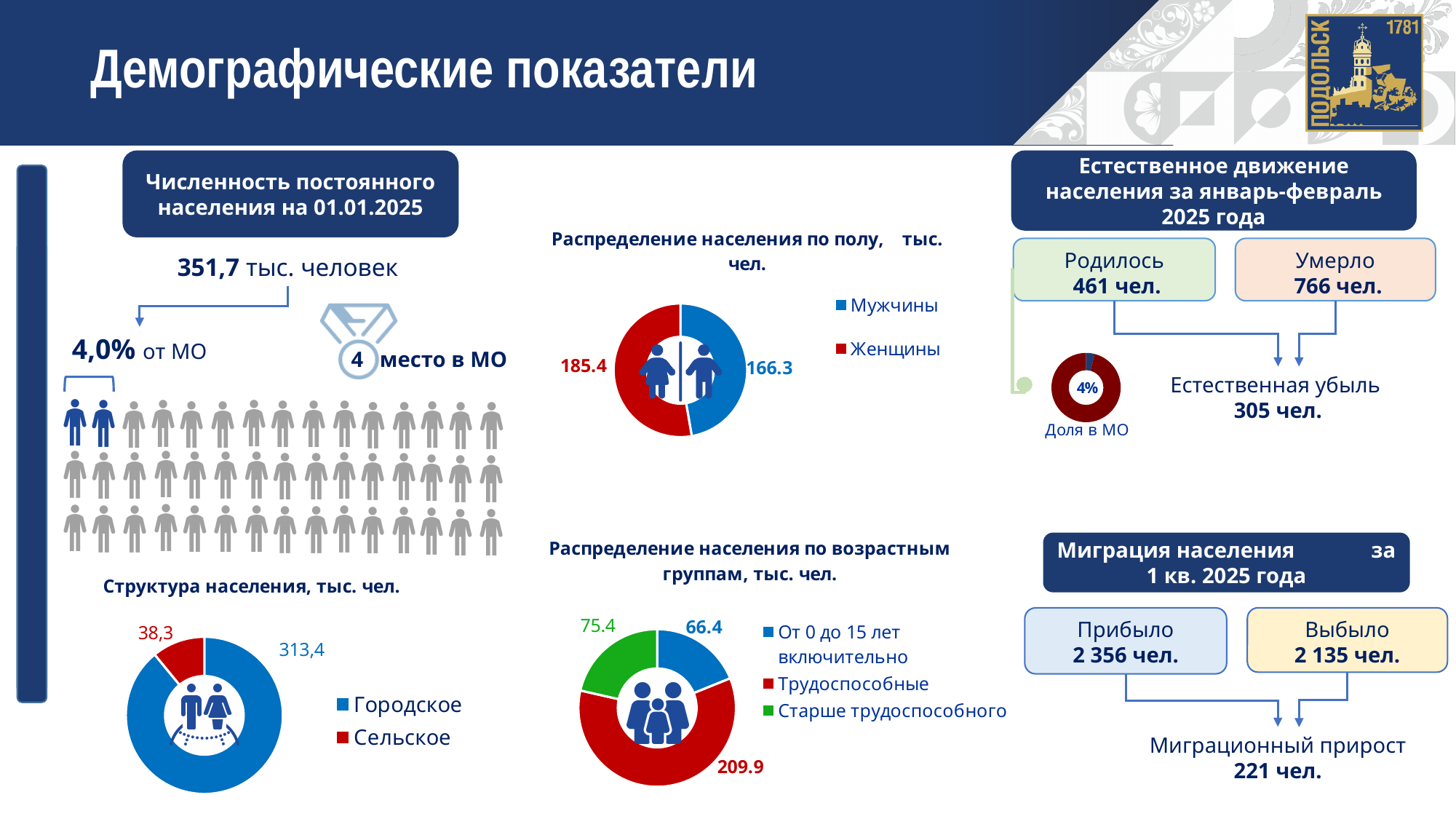
In the chart 'Структура населения, тыс. чел.', what is the difference between Городское and Сельское? 275,1 What kind of chart is 'Распределение населения по полу, тыс. чел.'? Doughnut chart In the chart 'Структура населения, тыс. чел.', which category is the largest? Городское In the chart 'Распределение населения по полу, тыс. чел.', what is the value for Мужчины? 166.3 In the chart 'Распределение населения по возрастным группам, тыс. чел.', what is the value for Трудоспособные? 209.9 In the chart 'Распределение населения по возрастным группам, тыс. чел.', which is larger: Старше трудоспособного or От 0 до 15 лет включительно? Старше трудоспособного What value is shown in the small 'Доля в МО' doughnut chart? 4% In the chart 'Распределение населения по возрастным группам, тыс. чел.', which age group has the smallest value? От 0 до 15 лет включительно In the chart 'Распределение населения по полу, тыс. чел.', what is the value for Женщины? 185.4 In the chart 'Распределение населения по возрастным группам, тыс. чел.', how many categories does the legend list? 3 In the chart 'Структура населения, тыс. чел.', what is the value for Сельское? 38,3 In the chart 'Распределение населения по полу, тыс. чел.', what is the difference between Женщины and Мужчины? 19.1